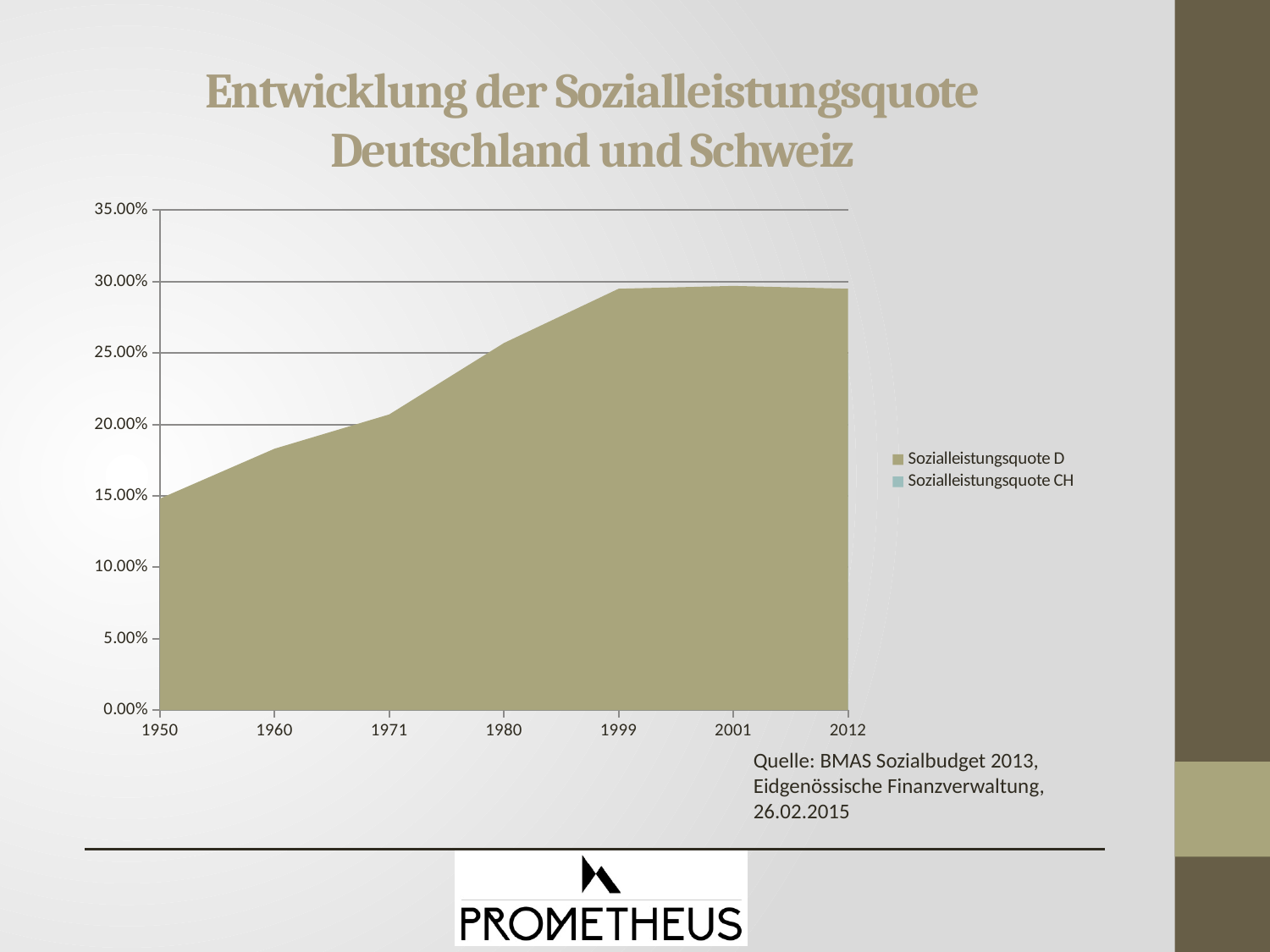
How many years are shown on the x axis? 7 Does the Sozialleistungsquote D rise or fall from 1950 to 1999? rise What is the title of the chart? Entwicklung der Sozialleistungsquote Deutschland und Schweiz What kind of chart is shown on the slide? area chart Is the value for Sozialleistungsquote D in 1980 greater or less than 20.00%? greater Is the value for Sozialleistungsquote D in 1960 greater or less than 20.00%? less Which is larger, the Sozialleistungsquote D in 1950 or in 1980? 1980 Is the value for Sozialleistungsquote D in 1999 greater or less than 25.00%? greater How many series does the legend list? 2 Which year has the lowest value for Sozialleistungsquote D? 1950